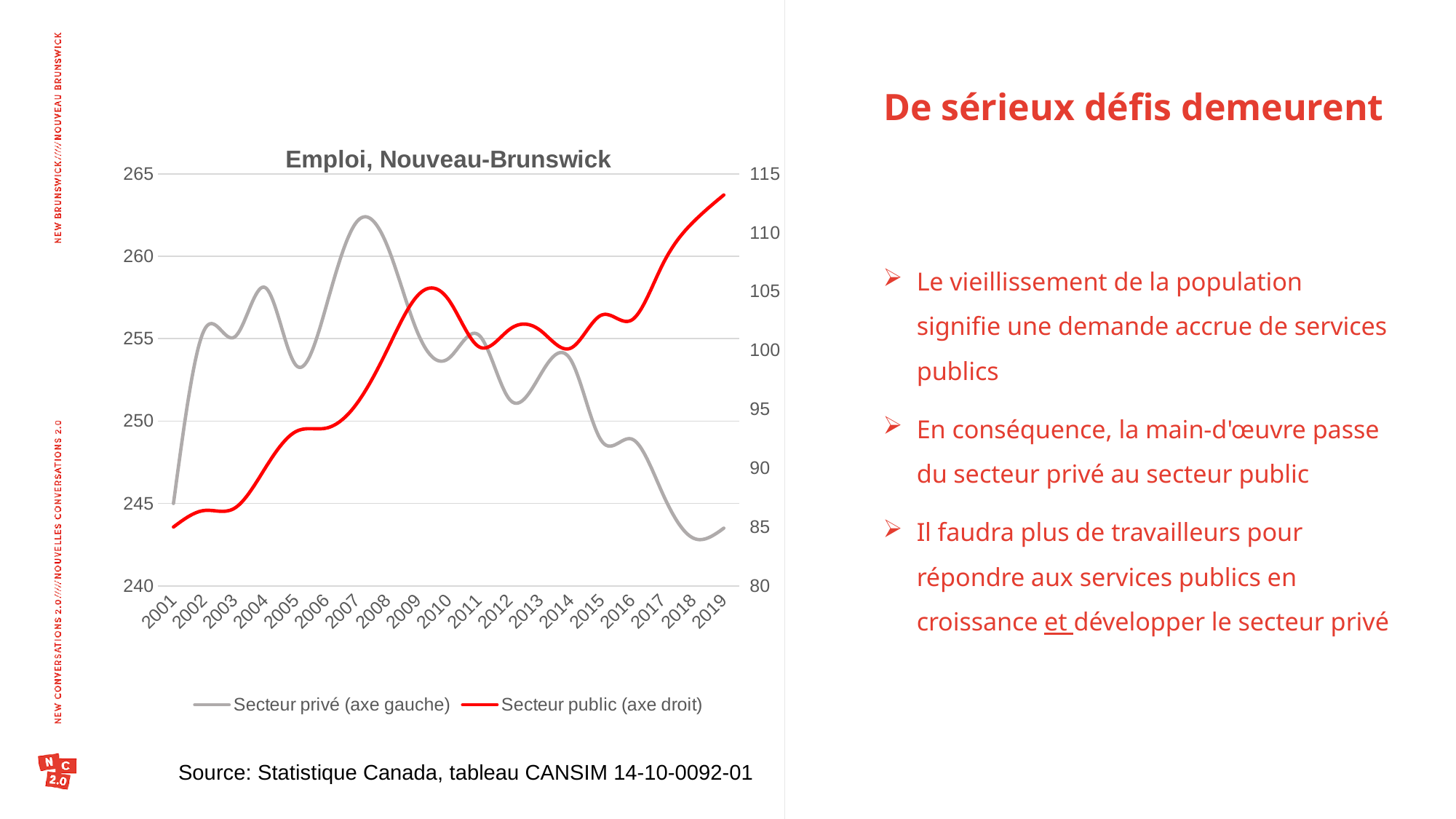
In which year does the Secteur privé series reach its highest value? 2007 Does the Secteur public series generally rise or fall from 2001 to 2019? rise Is the value for Secteur privé in 2007 greater or less than 260? greater How many series does the legend of the chart list? 2 In which year does the Secteur public series reach its highest value? 2019 Is the value for Secteur public in 2019 greater or less than 110? greater In which year does the Secteur public series reach its lowest value? 2001 How many years are shown along the x axis of the chart? 19 In which year does the Secteur privé series reach its lowest value? 2018 What is the title of the chart? Emploi, Nouveau-Brunswick Which series is drawn in red on the chart? Secteur public (axe droit) What kind of chart is shown on the slide? line chart